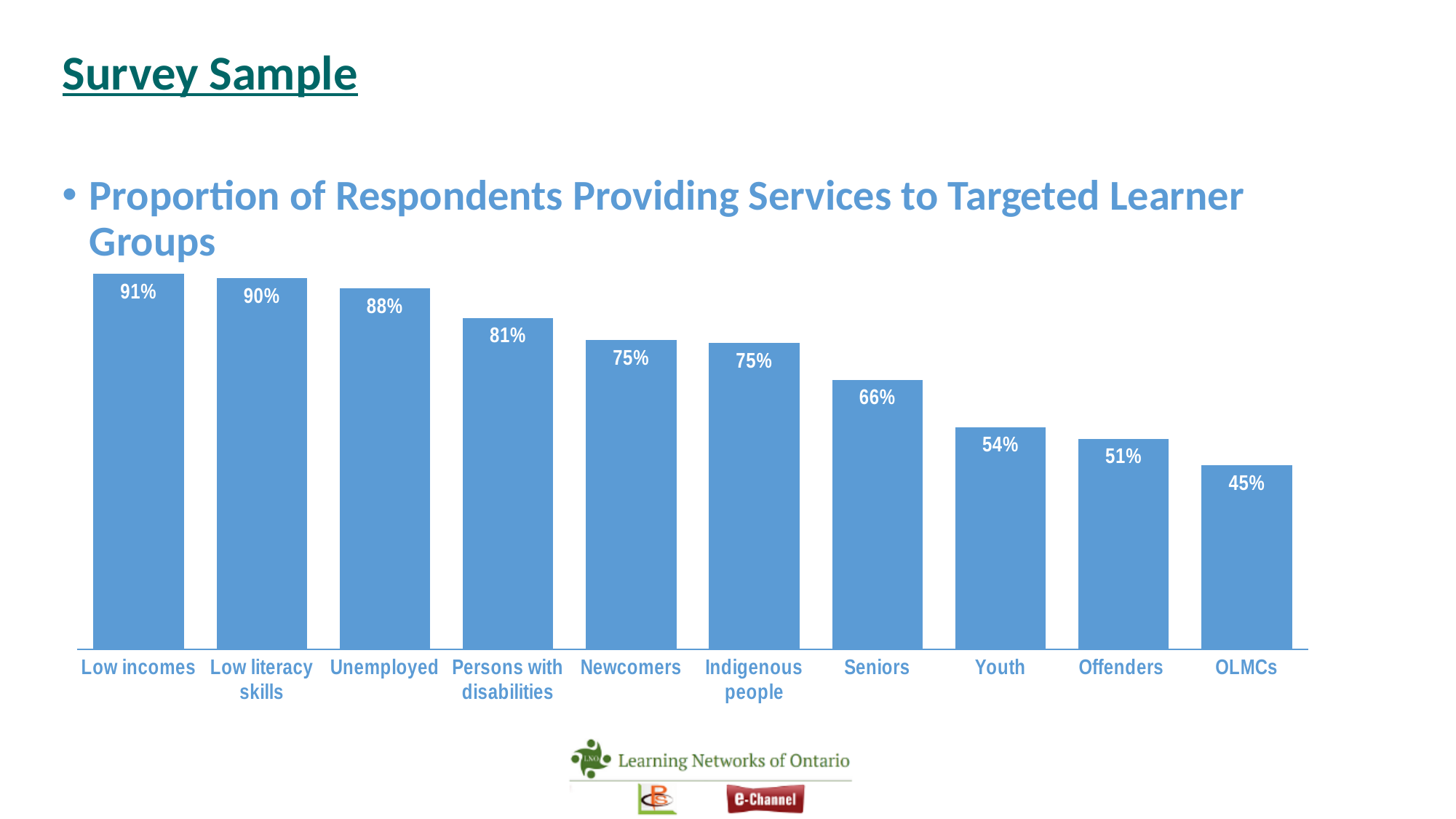
Which two learner groups share the same value of 75%? Newcomers and Indigenous people What is the value shown for Seniors? 66% How many learner groups are shown in the chart? 10 Which learner group has the lowest proportion of respondents providing services? OLMCs What proportion of respondents provide services to Low incomes? 91% Which is larger, the value for Seniors or the value for Youth? Seniors Which learner group has the highest proportion of respondents providing services? Low incomes What kind of chart is shown on the slide? Bar chart Do the values rise or fall from left to right across the chart? Fall What is the value shown for OLMCs? 45% What is the difference between the values for Persons with disabilities and Offenders? 30% What is the difference between the values for Unemployed and Youth? 34%